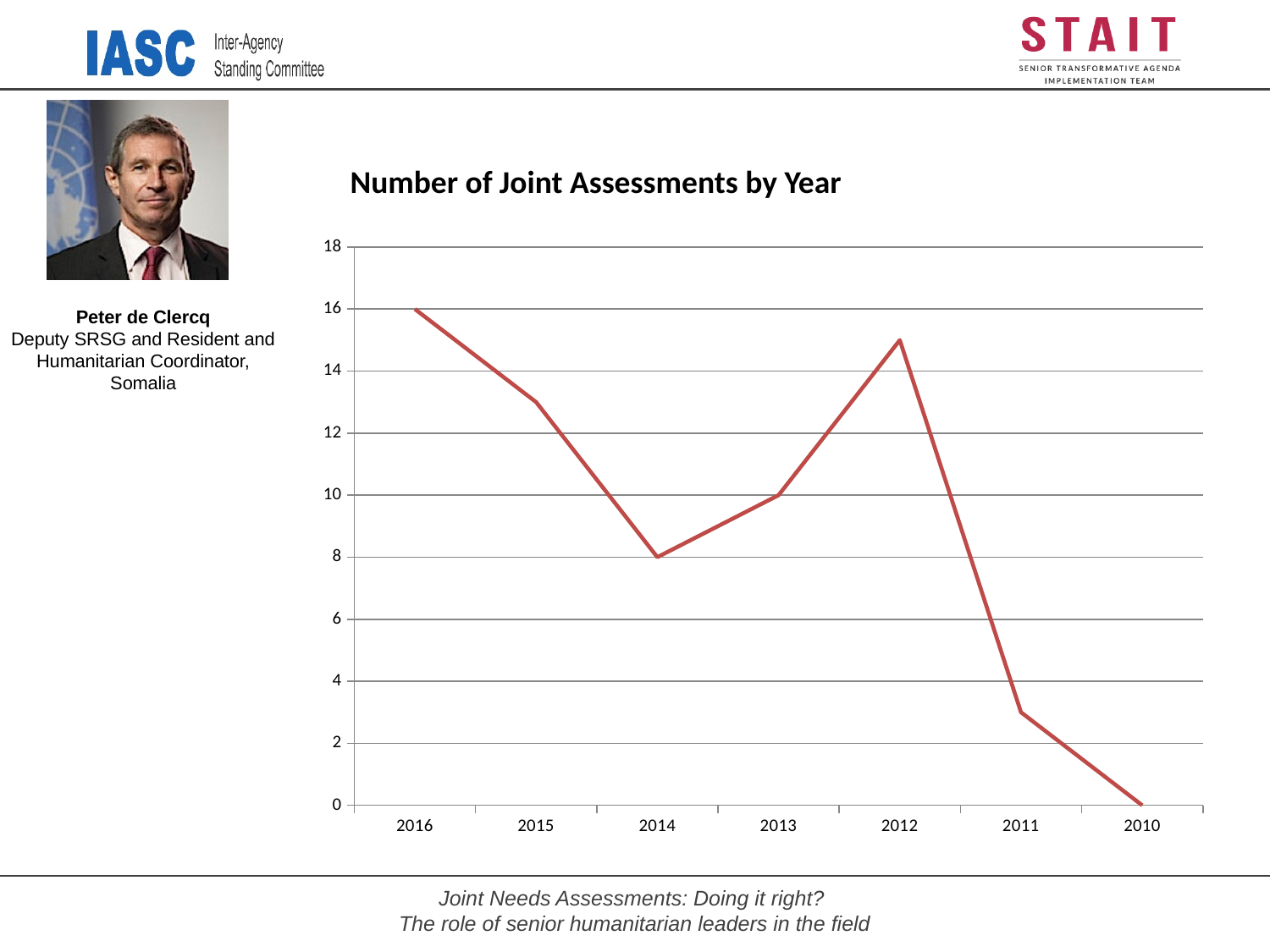
Is the value for 2011 greater or less than 4? less What is the difference between the number of joint assessments in 2016 and in 2014? 8 What type of chart is shown on the slide? Line chart Which year has the lowest number of joint assessments? 2010 Is the value for 2012 greater or less than 14? greater What is the title of the chart? Number of Joint Assessments by Year Which year has the highest number of joint assessments? 2016 What is the number of joint assessments for 2013? 10 How many years are plotted on the x axis of the chart? 7 What is the number of joint assessments for 2010? 0 What is the number of joint assessments for 2016? 16 What is the number of joint assessments for 2014? 8